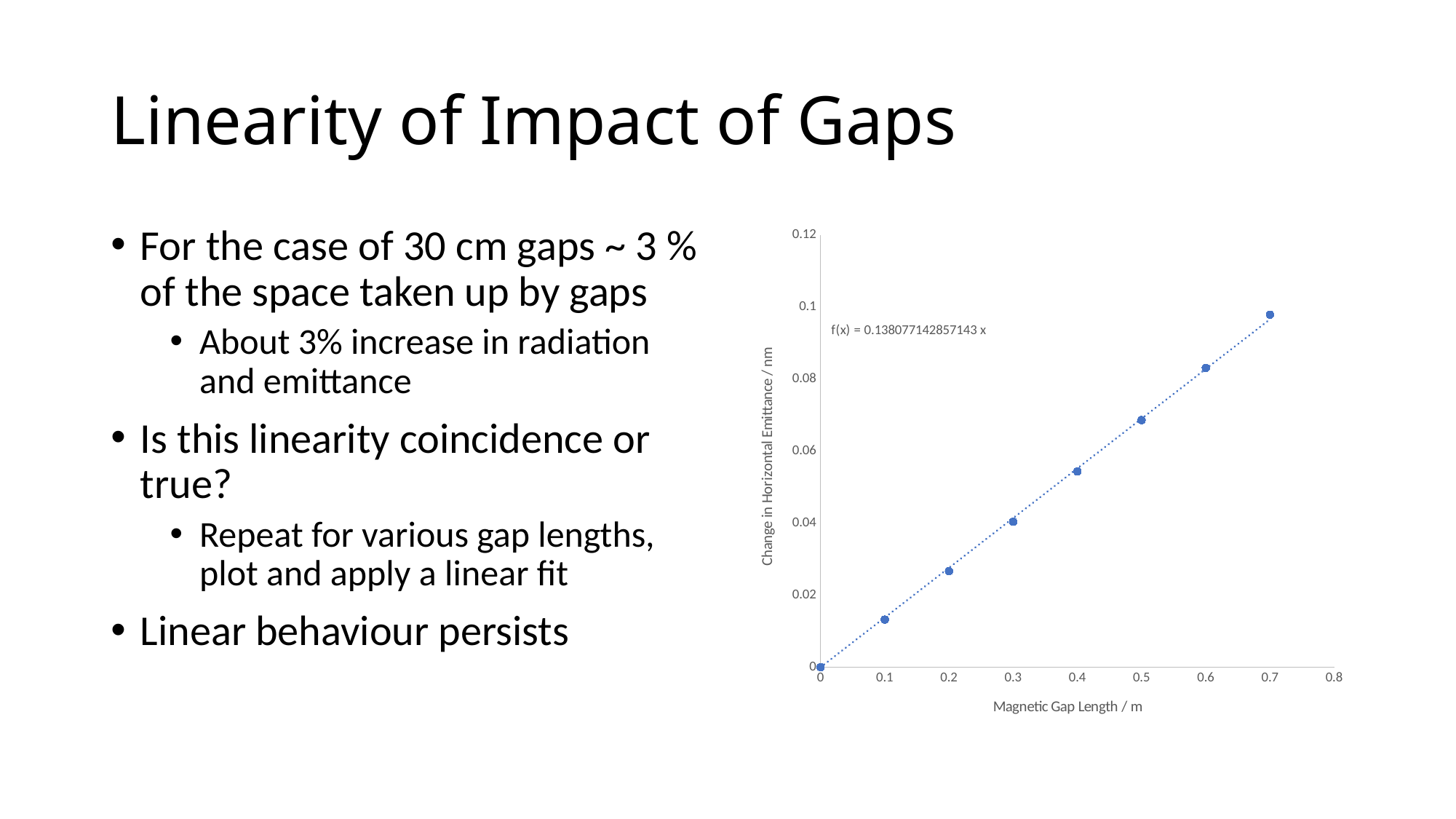
At which magnetic gap length is the change in horizontal emittance highest? 0.7 At which magnetic gap length is the change in horizontal emittance lowest? 0 Is the change in horizontal emittance at a gap length of 0.7 m greater or less than 0.08? greater How many data points are plotted on the chart? 8 Do the values rise or fall as the magnetic gap length increases? rise Is the change in horizontal emittance at a gap length of 0.5 m greater or less than 0.06? greater Which has the larger change in horizontal emittance: a gap length of 0.5 m or 0.2 m? 0.5 m What kind of chart is shown on the slide? scatter chart What is the title of the x axis of the chart? Magnetic Gap Length / m Is the change in horizontal emittance at a gap length of 0.1 m greater or less than 0.02? less What is the equation of the linear fit shown on the chart? f(x) = 0.138077142857143 x